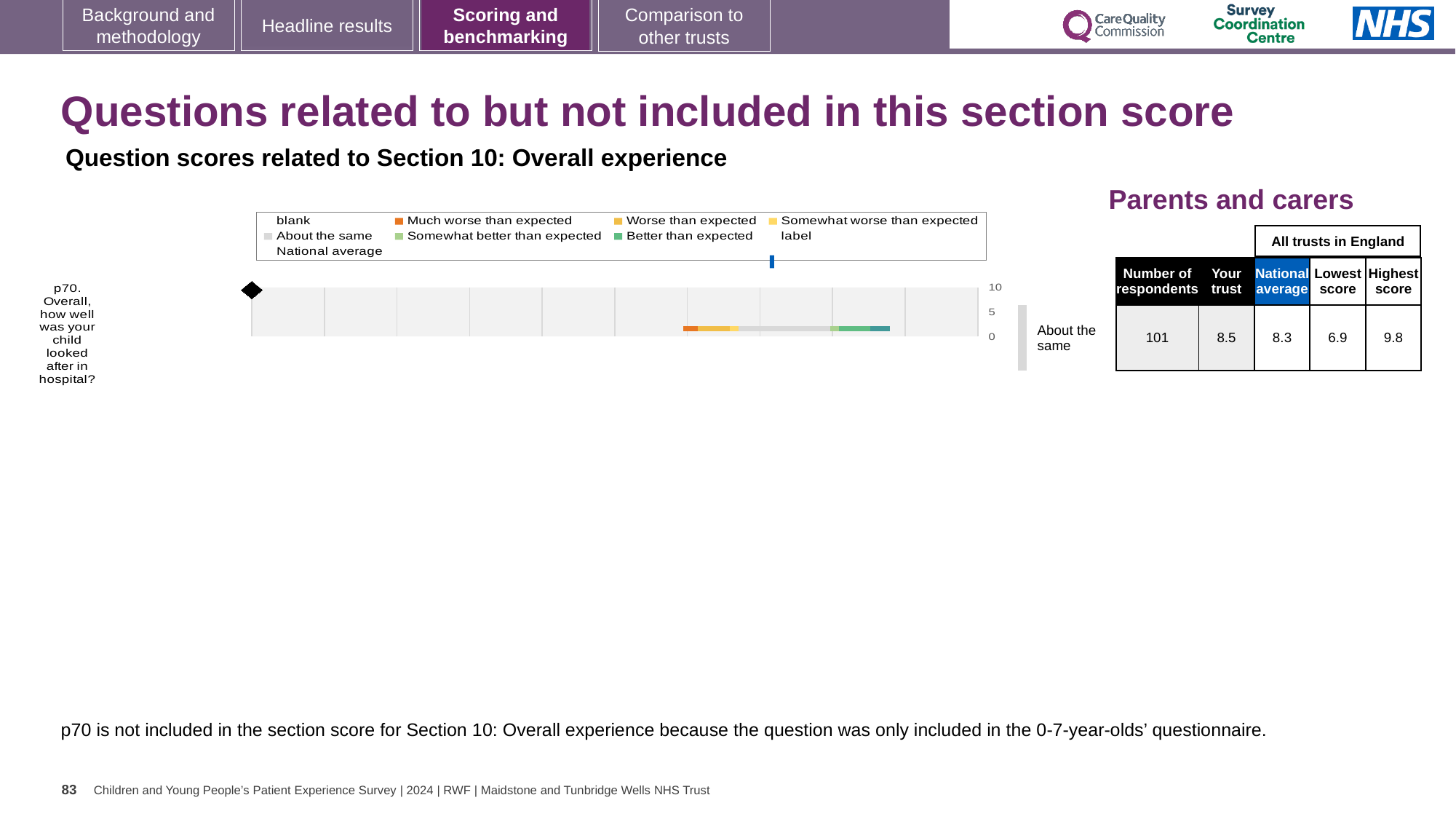
In the table beside the chart, what is the national average score for p70? 8.3 How many questions are plotted in the chart? 1 What is the highest tick value shown on the chart's axis? 10 How many entries does the chart legend list? 9 In the table beside the chart, what is the number of respondents for p70? 101 In the table beside the chart, what is the difference between the highest score and the lowest score for p70? 2.9 What kind of chart is shown for question p70? bar chart In the table beside the chart, what is the 'Your trust' score for p70? 8.5 What colour does the legend use for 'Much worse than expected'? orange In the table beside the chart, which is larger for p70: the 'Your trust' score or the national average? Your trust Which question is plotted in the chart? p70. Overall, how well was your child looked after in hospital? In the table beside the chart, what is the difference between the 'Your trust' score and the national average for p70? 0.2